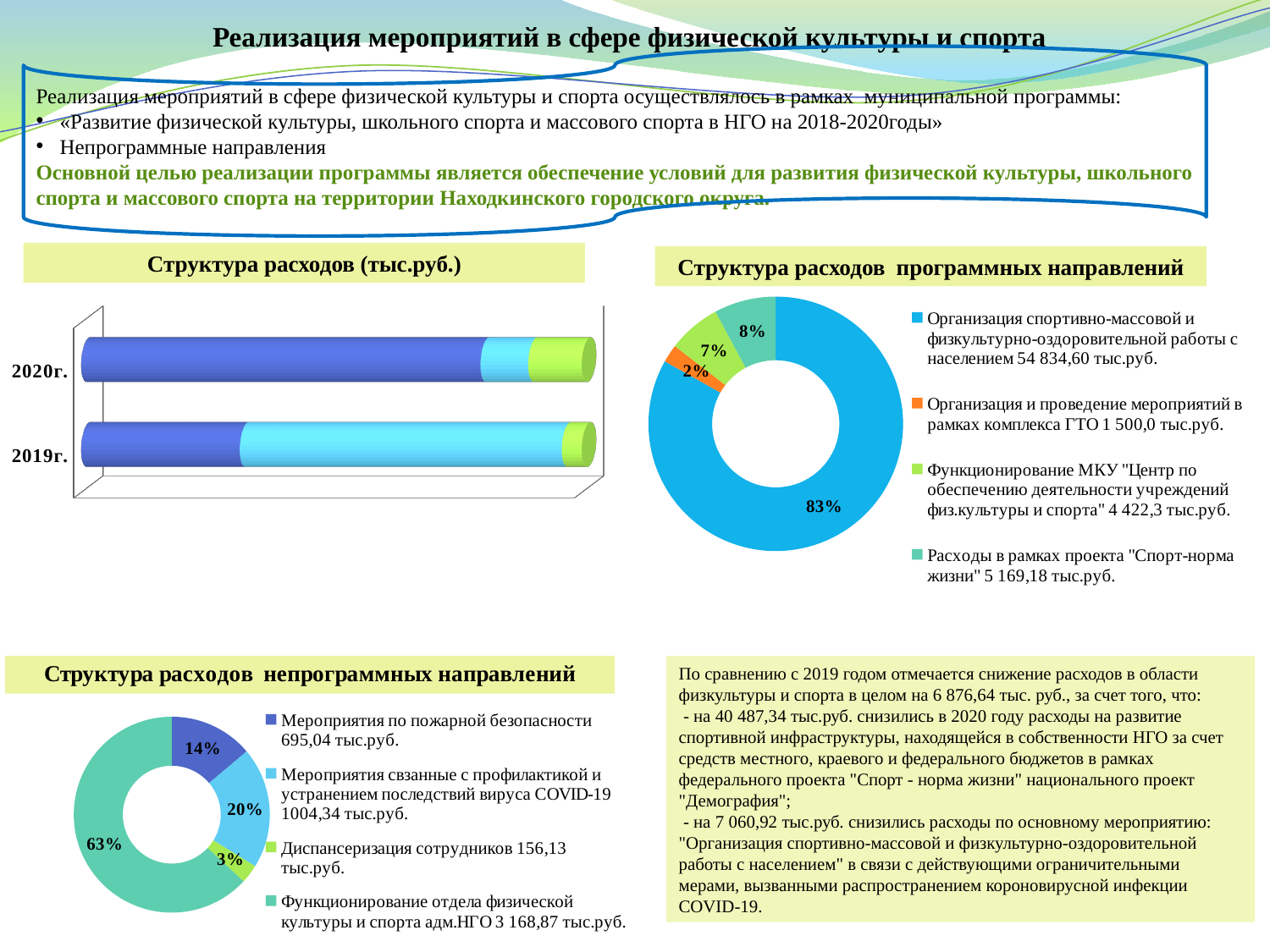
In the chart 'Структура расходов программных направлений', what share is shown for 'Организация спортивно-массовой и физкультурно-оздоровительной работы с населением'? 83% In the chart 'Структура расходов программных направлений', how many categories does the legend list? 4 In the chart 'Структура расходов программных направлений', which category has the largest share? Организация спортивно-массовой и физкультурно-оздоровительной работы с населением In the chart 'Структура расходов непрограммных направлений', which is larger: the share for 'Мероприятия по пожарной безопасности' or the share for 'Мероприятия связанные с профилактикой и устранением последствий вируса COVID-19'? Мероприятия связанные с профилактикой и устранением последствий вируса COVID-19 How many years (categories) are shown in the chart 'Структура расходов (тыс.руб.)'? 2 In the chart 'Структура расходов программных направлений', what amount is given in the legend for 'Расходы в рамках проекта "Спорт-норма жизни"'? 5 169,18 тыс.руб. In the chart 'Структура расходов непрограммных направлений', what share is shown for 'Функционирование отдела физической культуры и спорта адм.НГО'? 63% In the chart 'Структура расходов непрограммных направлений', what is the difference in percentage points between the share for 'Функционирование отдела физической культуры и спорта адм.НГО' and the share for 'Мероприятия по пожарной безопасности'? 49 percentage points In the chart 'Структура расходов непрограммных направлений', what share is shown for 'Диспансеризация сотрудников'? 3% In the chart 'Структура расходов программных направлений', which category has the smallest share? Организация и проведение мероприятий в рамках комплекса ГТО What kind of chart is 'Структура расходов (тыс.руб.)'? Stacked bar chart